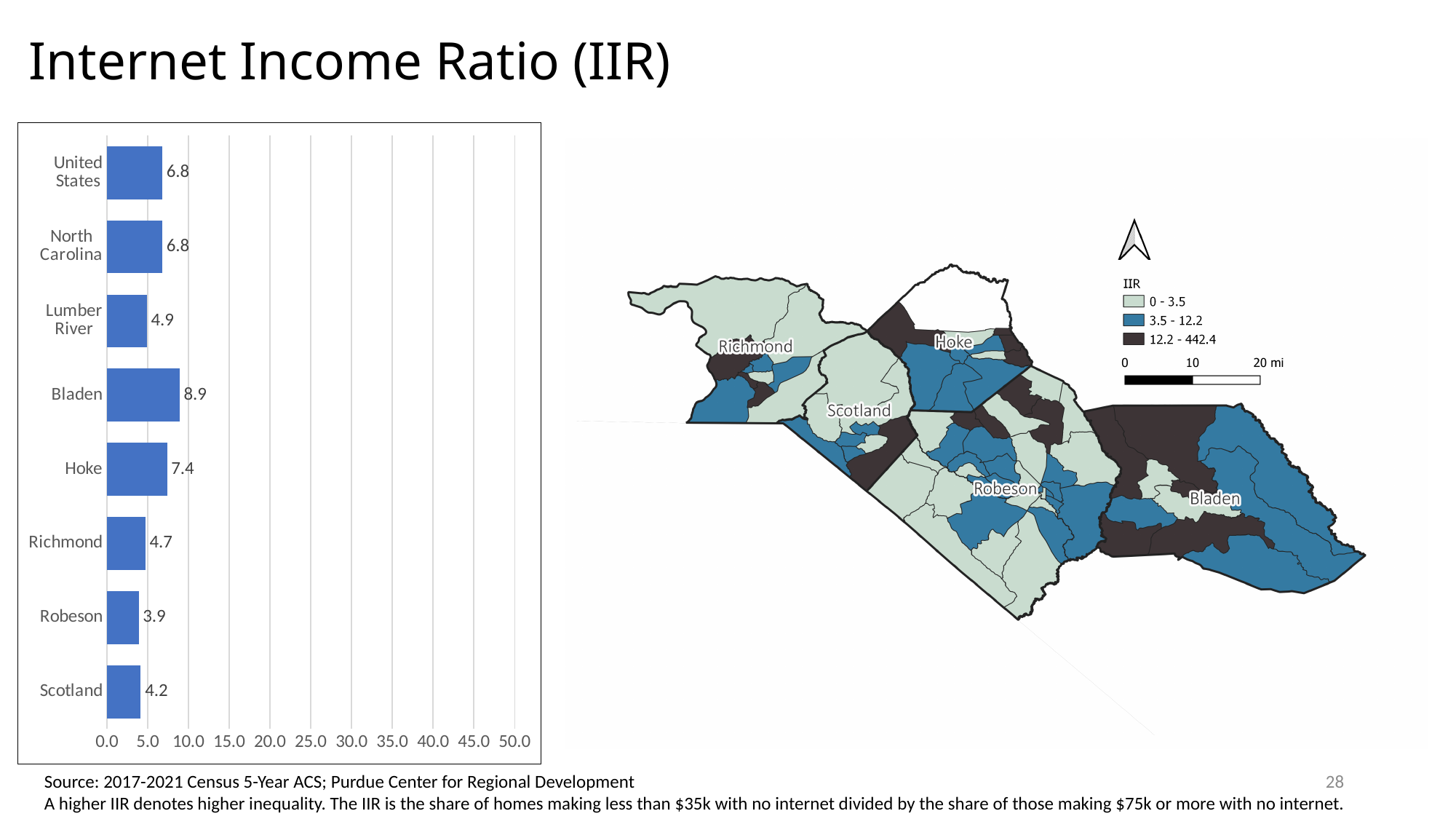
How many categories are shown in the bar chart? 8 What is the value for North Carolina in the bar chart? 6.8 What kind of chart is shown on the left of the slide? bar chart What is the IIR value for Lumber River in the bar chart? 4.9 What is the difference between the values for Bladen and Robeson in the bar chart? 5.0 Which category has the lowest value in the bar chart? Robeson Is the value for Hoke in the bar chart greater or less than 5.0? greater What is the IIR value for Bladen in the bar chart? 8.9 Which category has the highest value in the bar chart? Bladen What is the IIR value for Robeson in the bar chart? 3.9 What is the highest value shown on the x axis of the bar chart? 50.0 Which has a larger value in the bar chart, Hoke or Richmond? Hoke